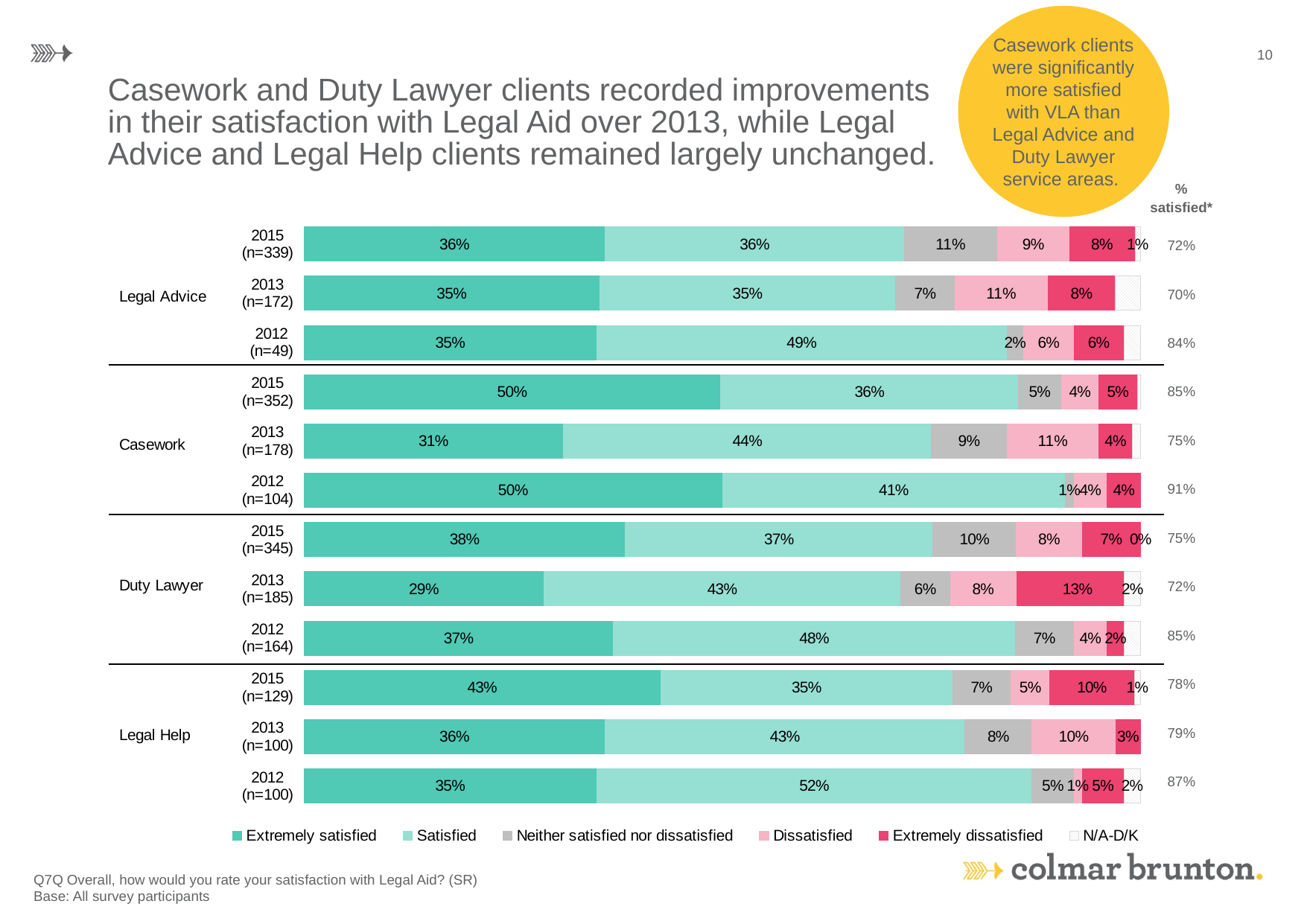
What is the sample size (n) for Casework in 2015? n=352 Which bar has the highest % satisfied figure? Casework 2012 (91%) What percentage of Duty Lawyer clients in 2013 were Extremely dissatisfied? 13% What kind of chart is shown on the slide? Stacked bar chart What percentage of Casework clients in 2015 were Extremely satisfied? 50% What is the combined share of Extremely satisfied and Satisfied for Duty Lawyer in 2015? 75% How many bars are plotted in the chart? 12 Which had a larger Extremely satisfied share in 2015: Legal Help or Legal Advice? Legal Help Which bar has the lowest % satisfied figure? Legal Advice 2013 (70%) By how many percentage points did the % satisfied for Casework change from 2013 to 2015? 10 percentage points How many series does the legend list? 6 What is the % satisfied figure for Casework in 2012? 91%